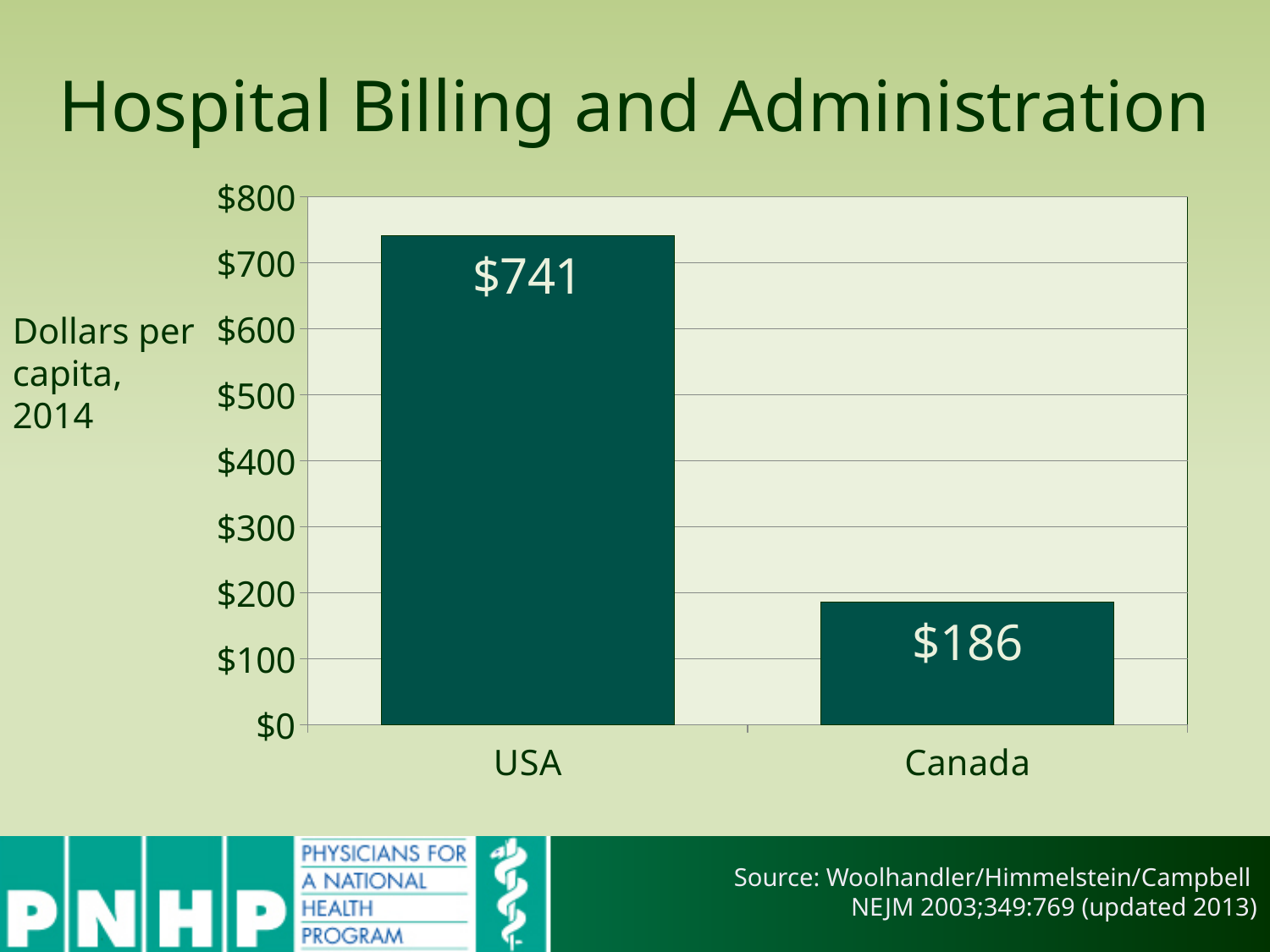
What is the title of the chart? Hospital Billing and Administration What is the value for USA? $741 What is the value for Canada? $186 What is the difference between the values for USA and Canada? $555 Which is larger, the value for USA or the value for Canada? USA How many categories are shown on the chart? 2 Is the value for Canada greater or less than $200? less Which category has the highest value? USA What unit does the y axis label describe? Dollars per capita, 2014 Which category has the lowest value? Canada What kind of chart is shown on the slide? bar chart Is the value for USA greater or less than $700? greater